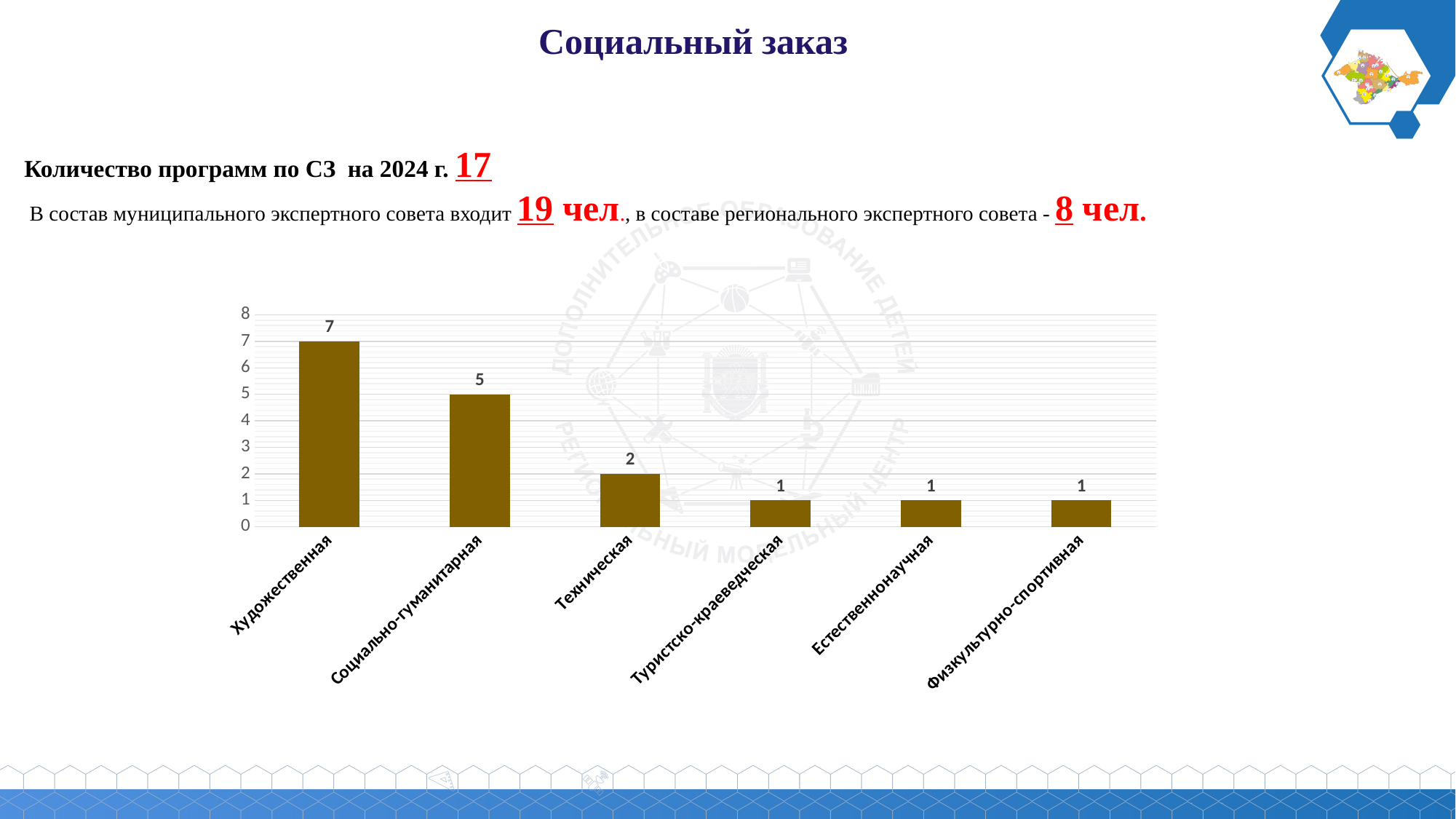
What is the value for Социально-гуманитарная? 5 Do the values rise or fall from left to right along the x axis? fall What is the difference between the values for Художественная and Социально-гуманитарная? 2 Is the value for Художественная greater or less than 6? greater What kind of chart is shown on the slide? bar chart Which is larger, the value for Техническая or the value for Туристско-краеведческая? Техническая What is the value for Естественнонаучная? 1 What is the value for Художественная? 7 What is the difference between the values for Социально-гуманитарная and Техническая? 3 Which category has the highest value? Художественная What is the value for Техническая? 2 How many categories are shown on the x axis? 6